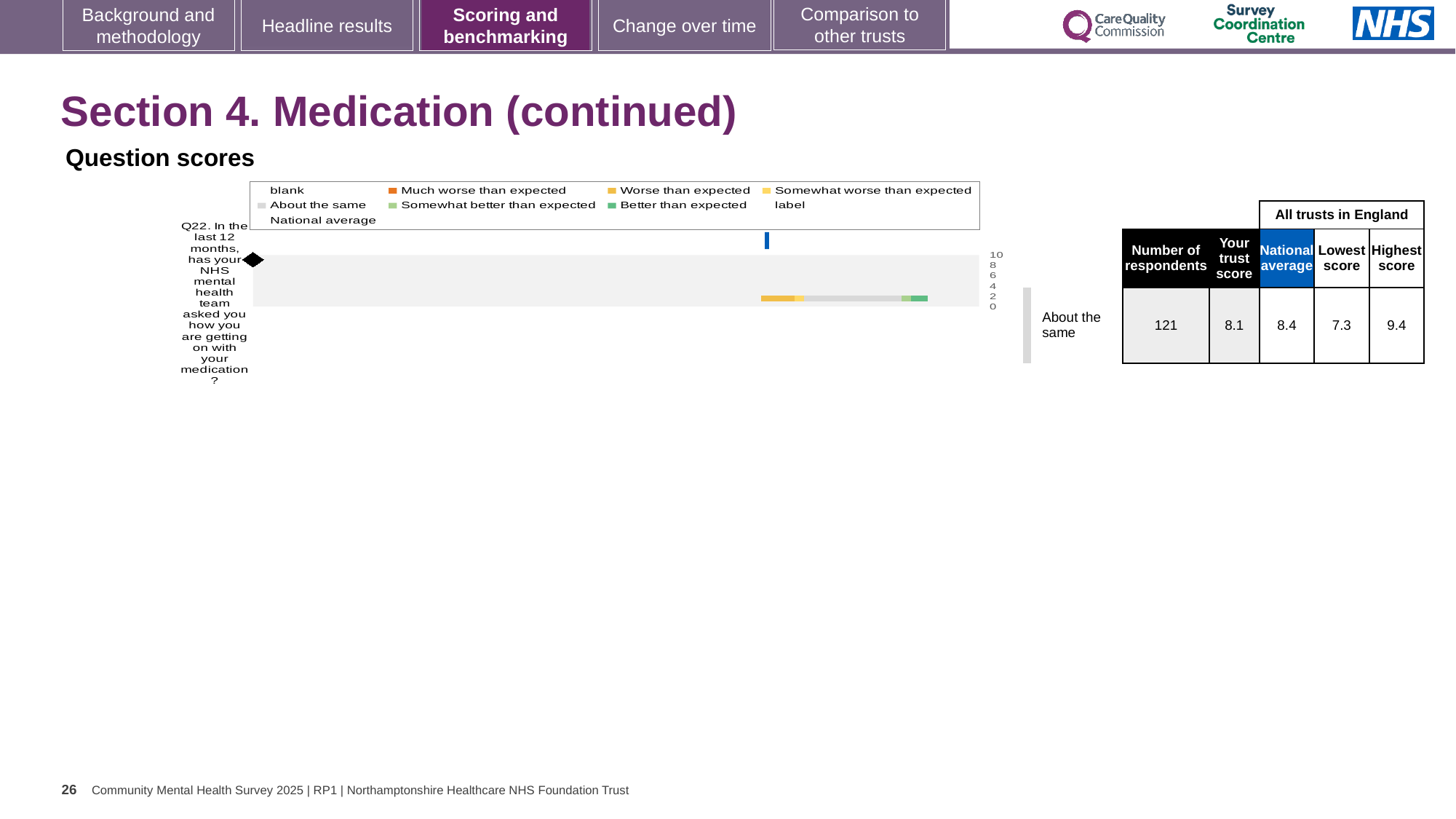
What is the highest score among all trusts in England for Q22? 9.4 What colour represents 'Much worse than expected' in the chart legend? Orange How many respondents answered Q22? 121 What kind of chart is used to show the Q22 question score? Bar chart How many questions are plotted on the chart? 1 What benchmarking category is the trust's Q22 score placed in? About the same What is the difference between the highest and lowest scores among all trusts in England for Q22? 2.1 What is the lowest score among all trusts in England for Q22? 7.3 What is the national average score for Q22 shown in the table? 8.4 What is the trust's score for Q22 shown in the table? 8.1 Which is larger for Q22, the trust's score or the national average? National average What is the difference between the national average and the trust's score for Q22? 0.3